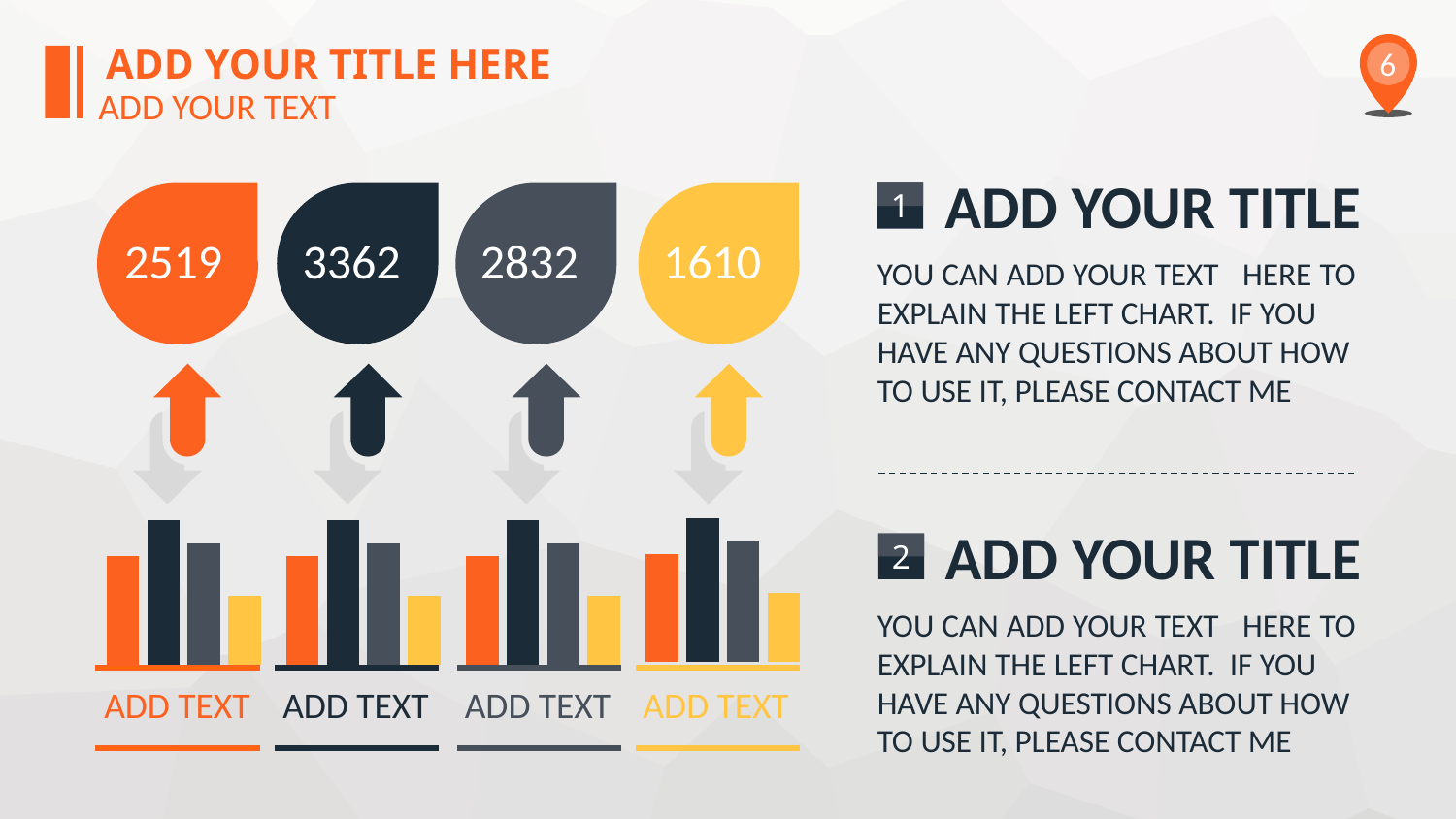
What is the difference between the values in the dark navy bubble and the orange bubble? 843 Which of the four bubbles shows the lowest value? The yellow (rightmost) bubble, 1610 In each small bar chart, which coloured bar is the tallest? The dark navy bar What value is shown in the dark navy (second) bubble? 3362 What value is shown in the orange (leftmost) bubble? 2519 What kind of chart appears beneath each bubble? Bar chart What value is shown in the grey (third) bubble? 2832 Which of the four bubbles shows the highest value? The dark navy (second) bubble, 3362 What is the difference between the values in the grey bubble and the yellow bubble? 1222 How many bubble values are shown on the slide? 4 What value is shown in the yellow (rightmost) bubble? 1610 Which is larger, the value in the grey bubble or the value in the orange bubble? The grey bubble (2832)